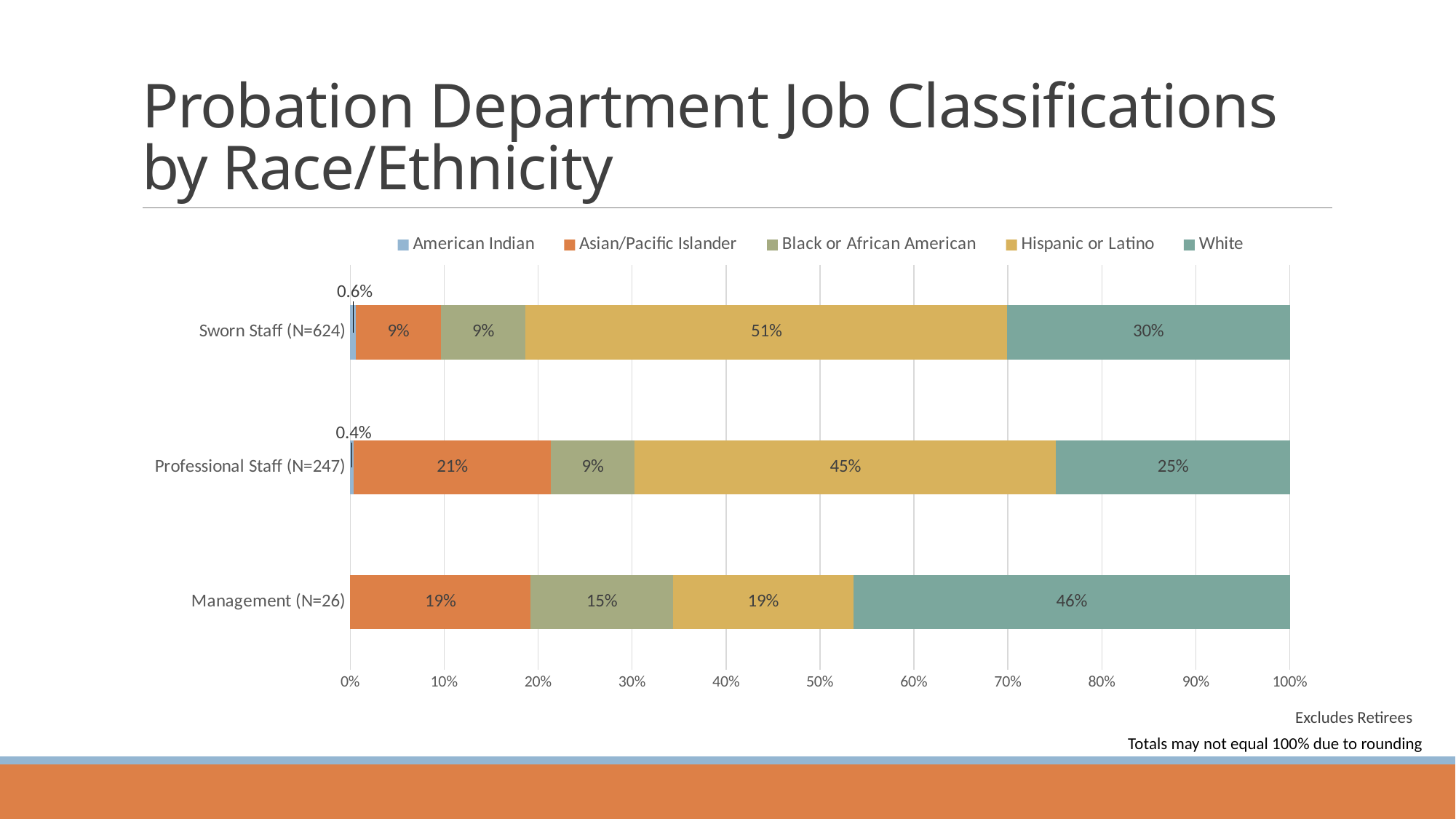
What is the N for Professional Staff? 247 Which job classification has the highest percentage of White staff? Management (N=26) How many job classifications are shown on the chart? 3 What percentage of Management are White? 46% How many series does the legend list? 5 What percentage of Sworn Staff are American Indian? 0.6% What percentage of Professional Staff are Asian/Pacific Islander? 21% What is the difference between the Hispanic or Latino percentage for Sworn Staff and for Professional Staff? 6% Which job classification has the lowest percentage of Hispanic or Latino staff? Management (N=26) What percentage of Sworn Staff are Hispanic or Latino? 51% What kind of chart is shown on the slide? Stacked bar chart Which is larger: the Asian/Pacific Islander share of Professional Staff or of Management? Professional Staff